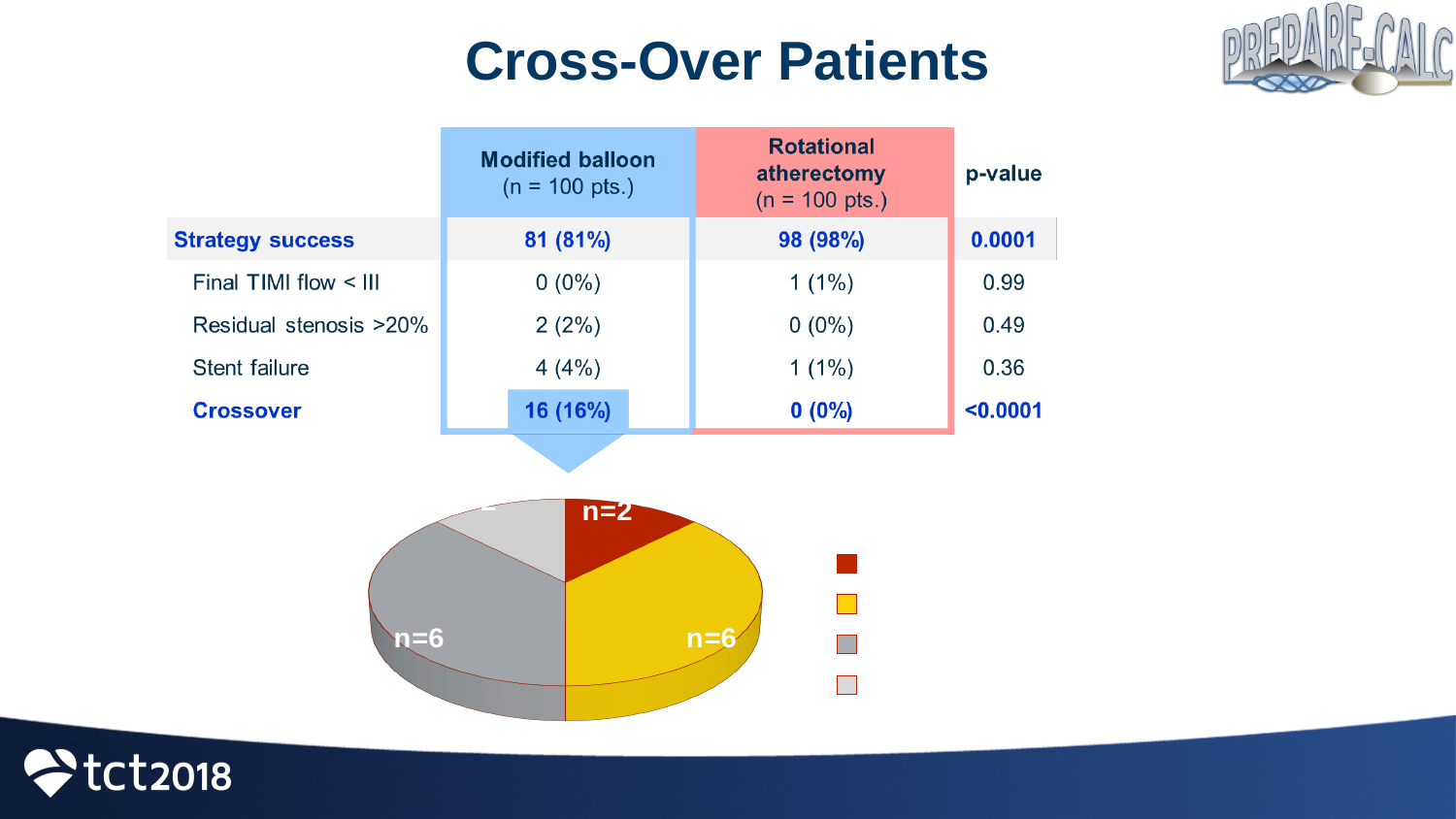
Which is larger in the pie chart, the yellow slice or the dark red slice? yellow slice Does the legend of the pie chart include text labels next to the colour swatches? No What value is labelled on the yellow slice of the pie chart? n=6 What is the difference between the yellow slice value and the dark red slice value in the pie chart? 4 Is the pie chart drawn in 3D? Yes What value is labelled on the dark gray slice of the pie chart? n=6 What kind of chart is shown on the slide? pie chart How many slices does the pie chart have? 4 What value is labelled on the dark red slice of the pie chart? n=2 How many entries does the legend of the pie chart show? 4